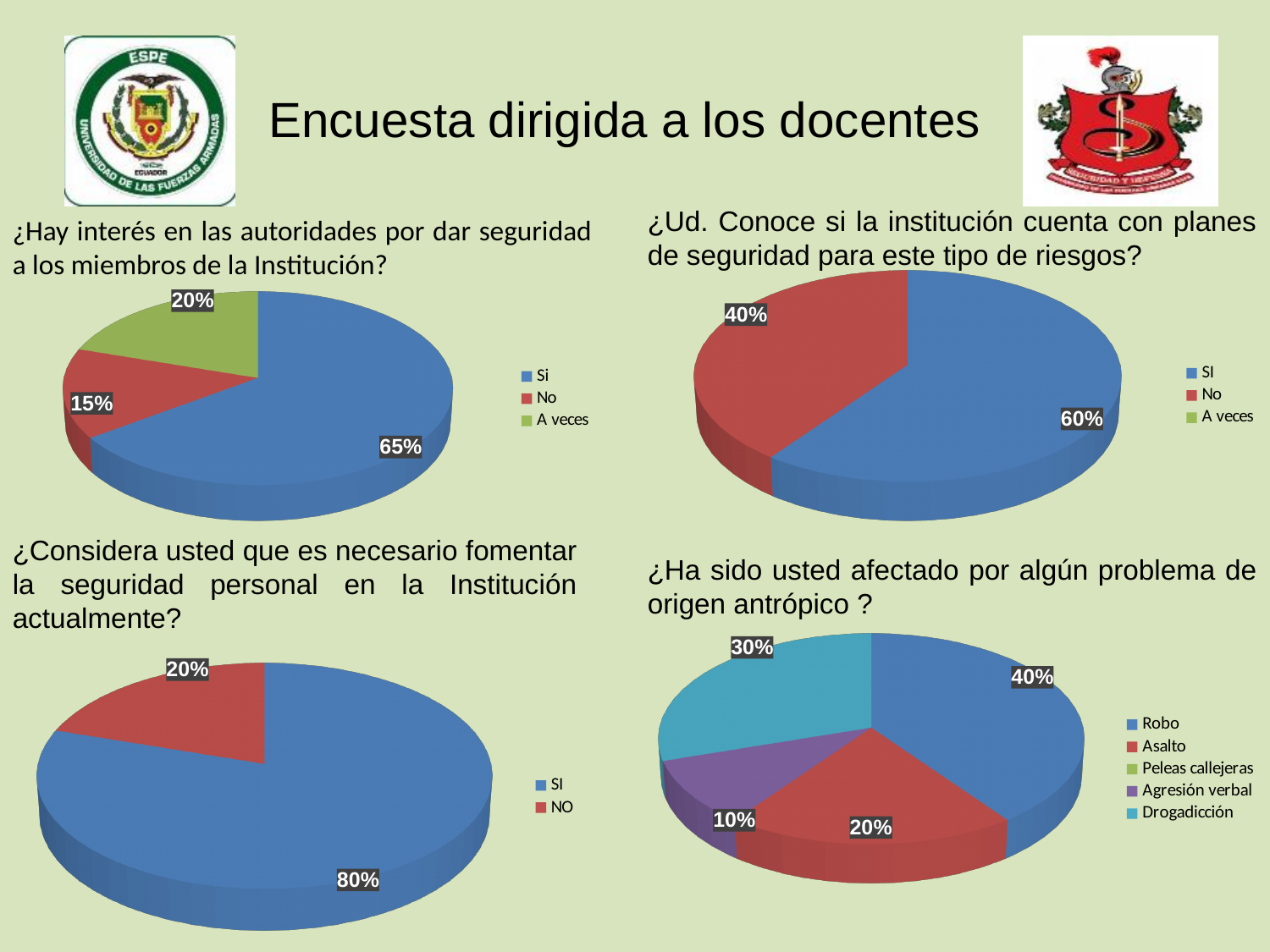
How many entries does the legend of the top-right pie chart list? 3 In the bottom-right pie chart, which category has the largest share? Robo In the top-right pie chart, which response has the largest share? SI What type of chart is used for the bottom-right chart about problems of anthropic origin? Pie chart In the bottom-left pie chart, what is the difference between the "SI" and "NO" shares? 60% In the top-left pie chart, which response has the smallest share? No In the top-right pie chart, what percentage of respondents answered "No"? 40% In the top-left pie chart, what is the difference between the "Si" share and the "No" share? 50% In the top-left pie chart, what percentage of respondents answered "Si"? 65% In the bottom-left pie chart, what percentage of respondents answered "SI"? 80% In the top-left pie chart, what percentage corresponds to "A veces"? 20% In the bottom-right pie chart, what percentage corresponds to "Drogadicción"? 30%